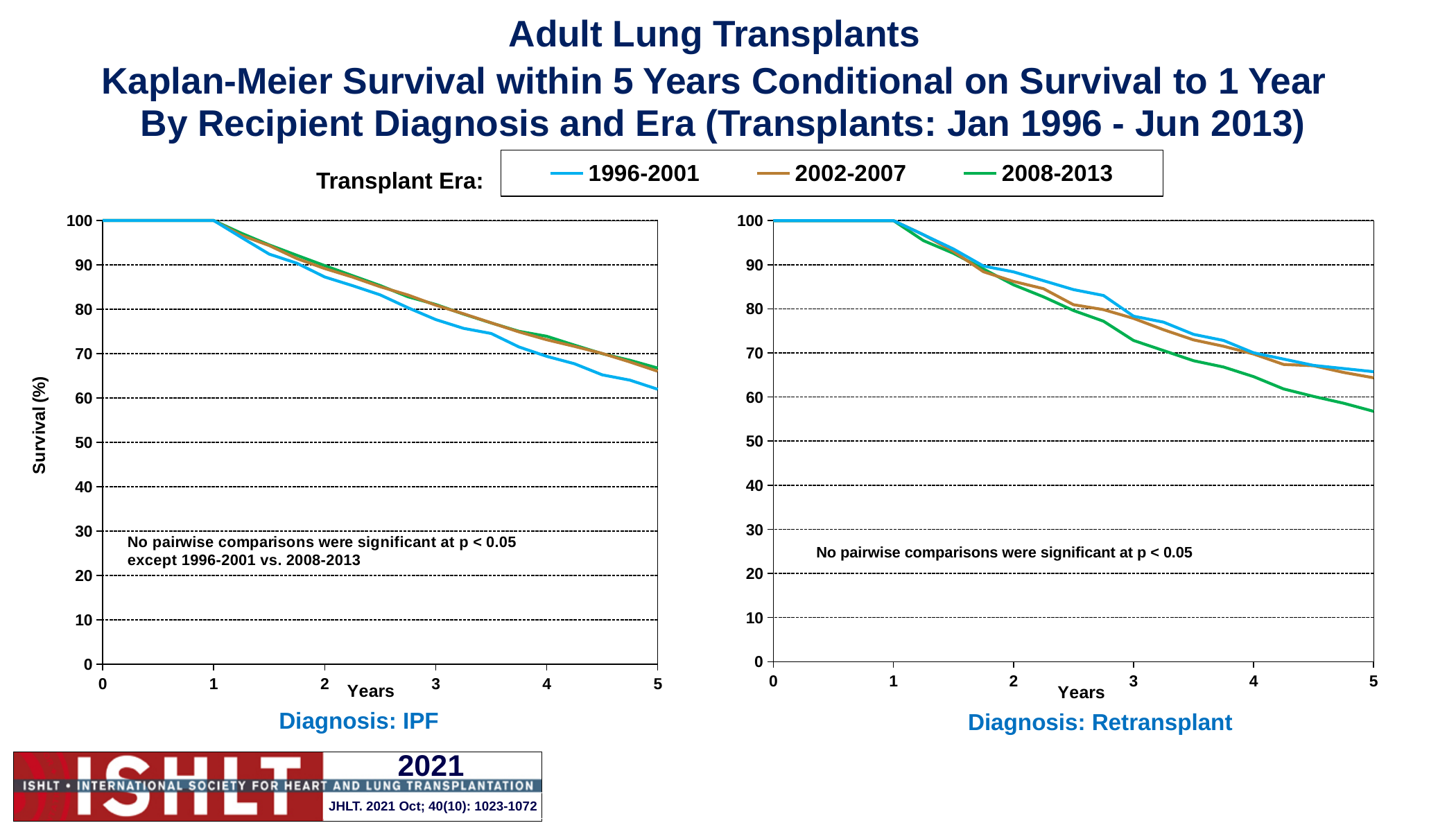
In the 'Diagnosis: IPF' chart, which era has the lowest survival at 5 years? 1996-2001 In the 'Diagnosis: IPF' chart, what is the survival value at 1 year for the 1996-2001 era? 100 How many transplant eras does the legend list? 3 In the 'Diagnosis: Retransplant' chart, is the survival value for the 1996-2001 era at 5 years greater or less than 60? greater What is the label of the x axis on the 'Diagnosis: Retransplant' chart? Years In the 'Diagnosis: Retransplant' chart, which era has the lowest survival at 5 years? 2008-2013 In the 'Diagnosis: IPF' chart, is the survival value for the 1996-2001 era at 5 years greater or less than 70? less In the 'Diagnosis: Retransplant' chart, is the survival value for the 2008-2013 era at 5 years greater or less than 60? less In the 'Diagnosis: Retransplant' chart, at 3 years, which era has higher survival: 1996-2001 or 2008-2013? 1996-2001 In the 'Diagnosis: Retransplant' chart, what is the survival value at 1 year for the 2008-2013 era? 100 What kind of chart is the 'Diagnosis: IPF' chart? line chart In the 'Diagnosis: IPF' chart, do the survival curves rise or fall as years increase after year 1? fall